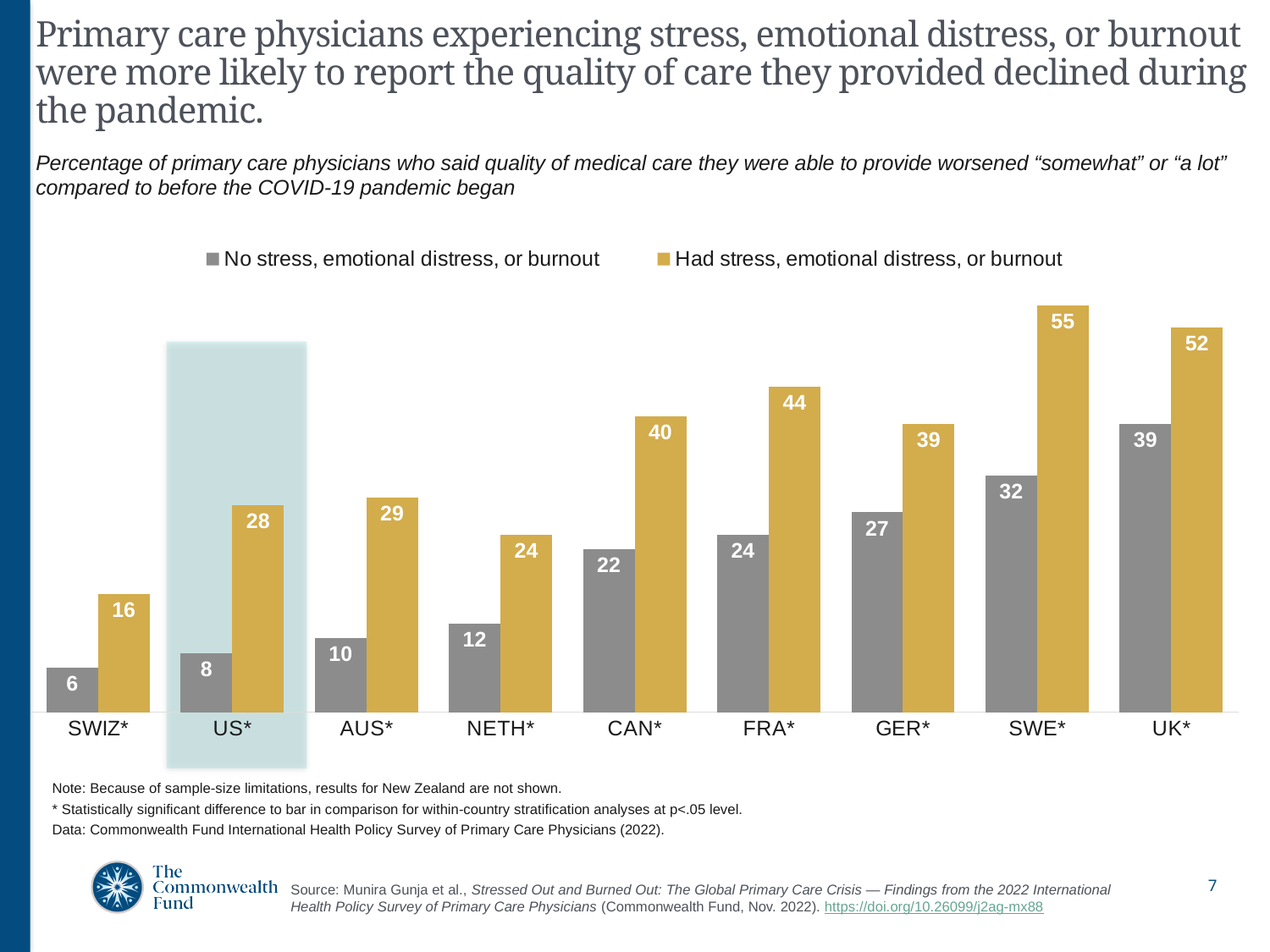
Which colour represents the 'Had stress, emotional distress, or burnout' series? Gold/yellow How many series does the legend list? 2 Which is larger: the 'Had stress, emotional distress, or burnout' value for CAN* or for GER*? CAN* What is the value for FRA* in the 'No stress, emotional distress, or burnout' series? 24 How many countries are shown on the x axis? 9 Which country has the highest value in the 'Had stress, emotional distress, or burnout' series? SWE* What kind of chart is shown on the slide? Bar chart What is the value for SWE* in the 'No stress, emotional distress, or burnout' series? 32 What is the difference between the 'Had stress' values for SWE* and UK*? 3 What is the difference between the 'Had stress' and 'No stress' values for US*? 20 Which country has the lowest value in the 'No stress, emotional distress, or burnout' series? SWIZ* What is the value for US* in the 'Had stress, emotional distress, or burnout' series? 28